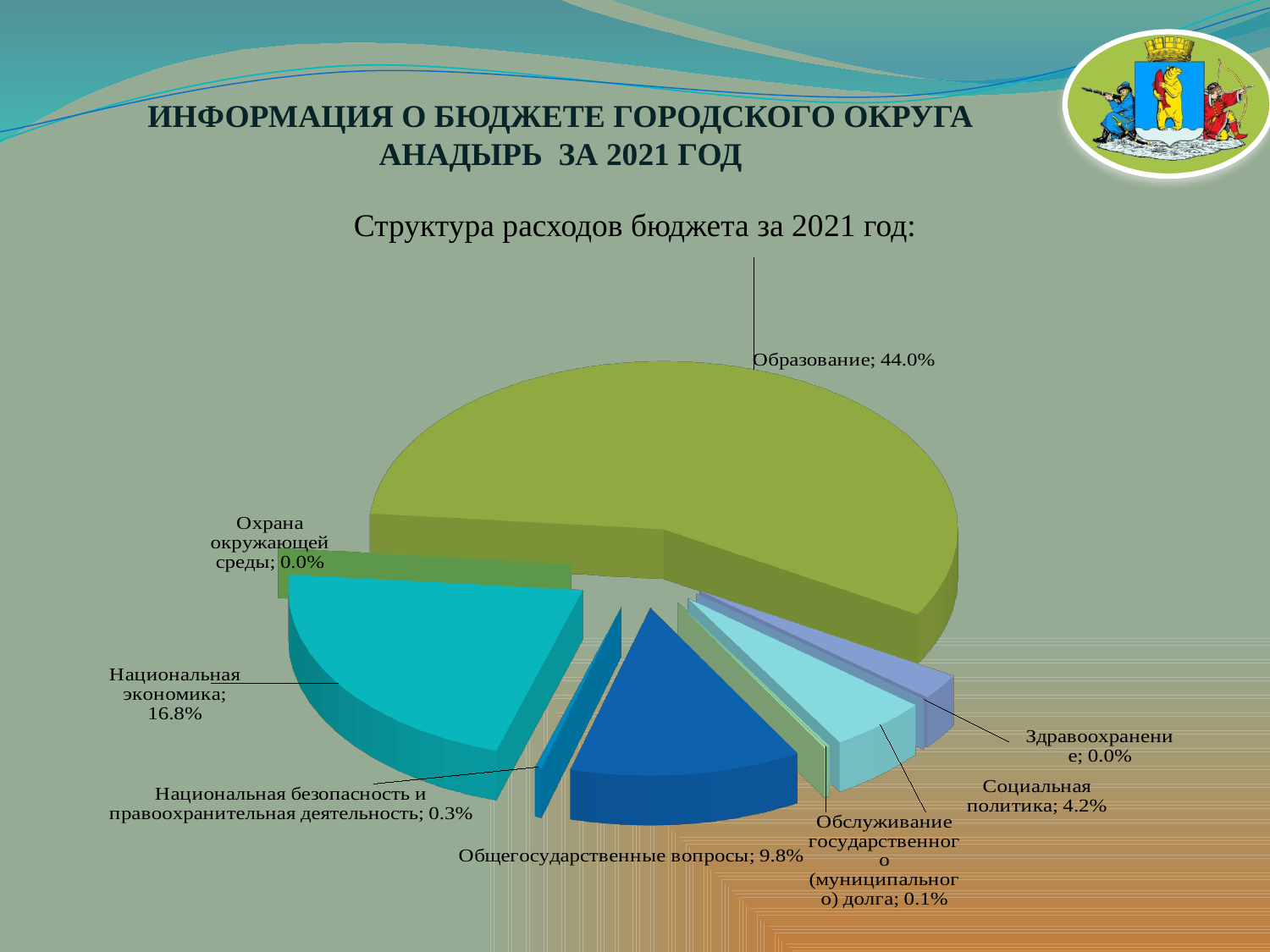
What is the value shown for Национальная экономика? 16.8% Which category has the largest share of the pie? Образование What is the title of the chart? Структура расходов бюджета за 2021 год: What share of budget expenditure does Образование account for? 44.0% What is the value for Социальная политика? 4.2% Which is larger, Национальная экономика or Общегосударственные вопросы? Национальная экономика What is the value for Национальная безопасность и правоохранительная деятельность? 0.3% What percentage is shown for Общегосударственные вопросы? 9.8% What is the difference between the shares of Образование and Национальная экономика? 27.2% What kind of chart is shown on the slide? pie chart How many labelled categories does the pie chart show? 8 What percentage is labelled for Обслуживание государственного (муниципального) долга? 0.1%